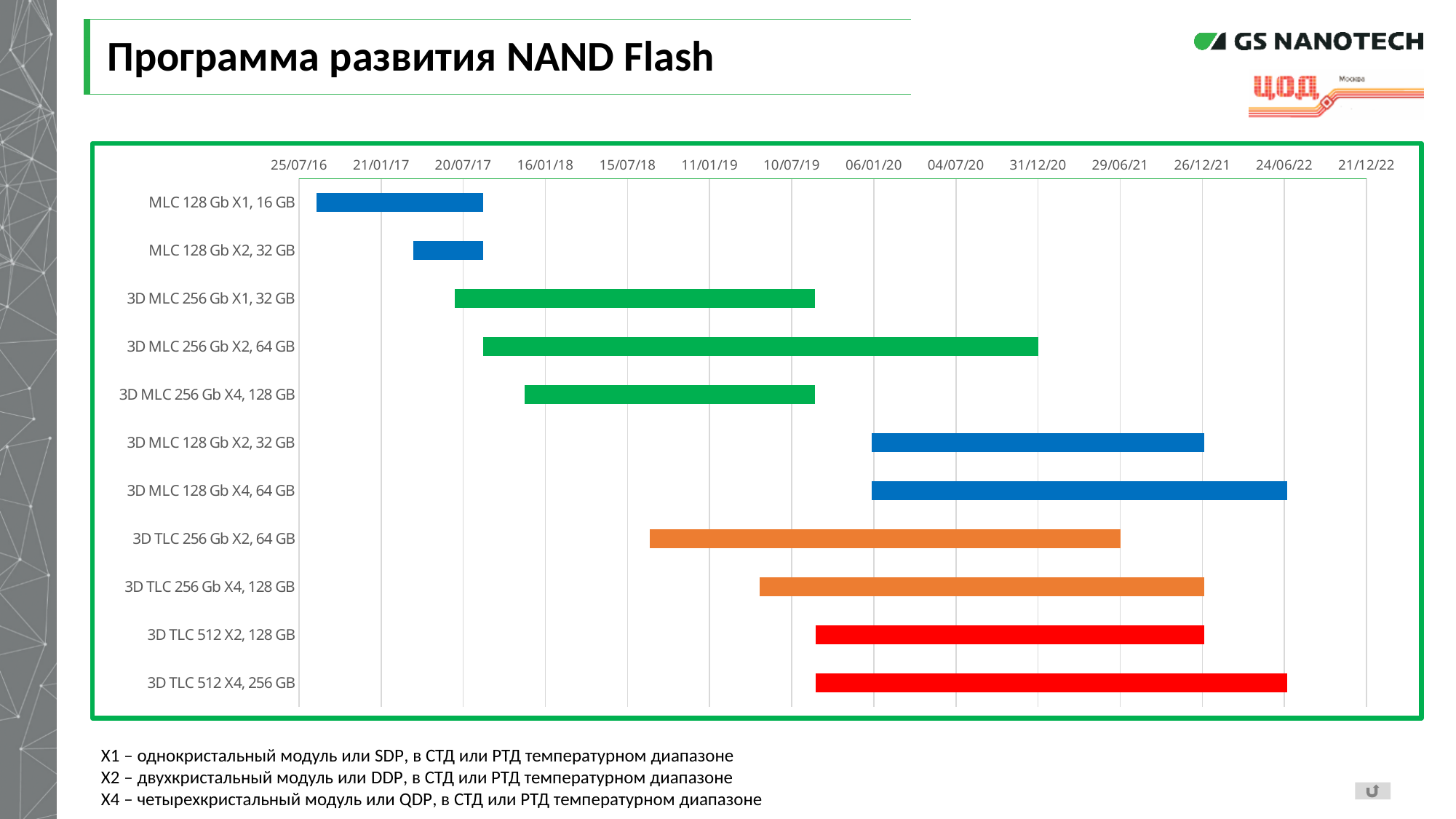
Which bar starts later: 3D TLC 256 Gb X2, 64 GB or 3D TLC 256 Gb X4, 128 GB? 3D TLC 256 Gb X4, 128 GB Which product's bar starts earliest on the timeline? MLC 128 Gb X1, 16 GB Which product has the shortest bar in the chart? MLC 128 Gb X2, 32 GB Which product has the longest bar in the chart? 3D MLC 256 Gb X2, 64 GB Does the bar for MLC 128 Gb X1, 16 GB end before or after 20/07/17? after What kind of chart is shown on the slide? Bar chart (Gantt chart) What is the title of the slide containing the chart? Программа развития NAND Flash How many product categories are listed on the vertical axis of the chart? 11 What colour are the bars for the 3D TLC 512 products? Red